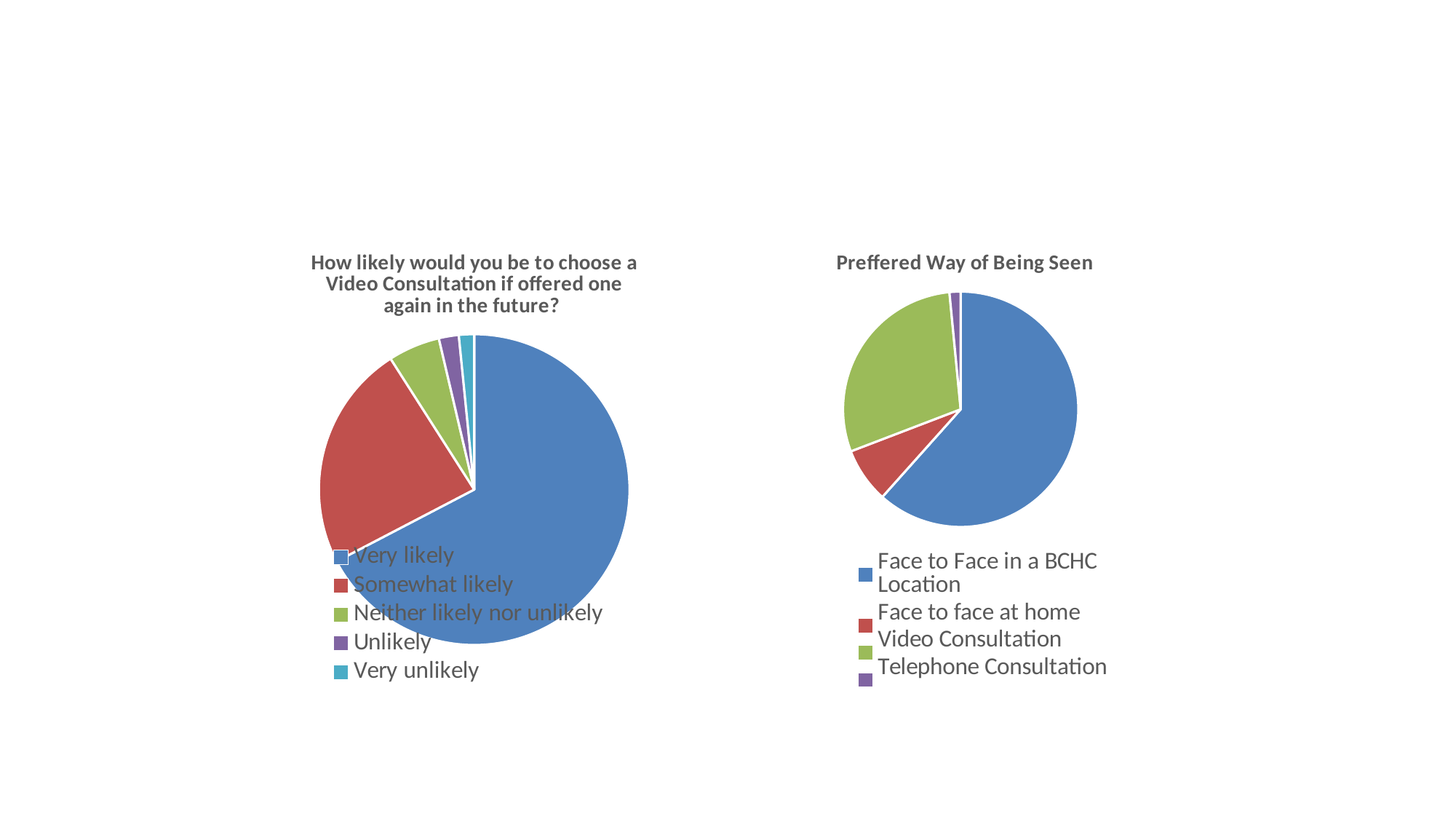
In the left chart about choosing a Video Consultation again, which category has the largest slice? Very likely What is the title of the right chart on the slide? Preffered Way of Being Seen In the left chart about choosing a Video Consultation again, which slice is larger: Somewhat likely or Neither likely nor unlikely? Somewhat likely In the chart titled "Preffered Way of Being Seen", which slice is larger: Video Consultation or Face to face at home? Video Consultation In the left chart about choosing a Video Consultation again, which slice is larger: Very likely or Somewhat likely? Very likely In the chart titled "Preffered Way of Being Seen", how many categories does the legend list? 4 In the left chart about choosing a Video Consultation again, how many categories does the legend list? 5 What kind of chart is the left chart about choosing a Video Consultation again in the future? pie chart In the chart titled "Preffered Way of Being Seen", which category has the smallest slice? Telephone Consultation What kind of chart is the chart titled "Preffered Way of Being Seen"? pie chart In the chart titled "Preffered Way of Being Seen", which category has the largest slice? Face to Face in a BCHC Location In the chart titled "Preffered Way of Being Seen", what colour is the Video Consultation slice? green